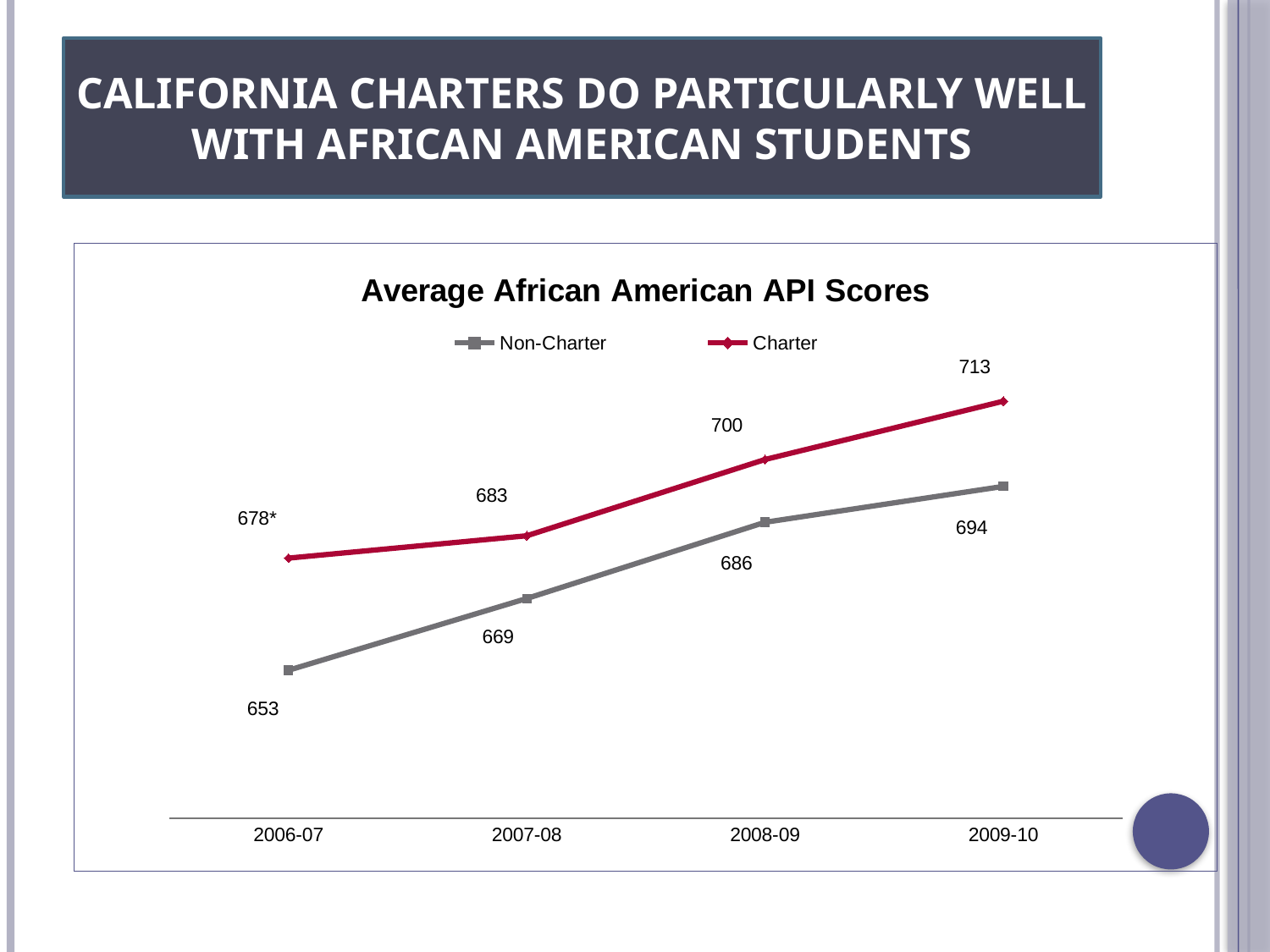
In which year is the Non-Charter score lowest? 2006-07 How many series does the legend list? 2 What kind of chart is shown? Line chart Do the Non-Charter scores rise or fall from 2006-07 to 2009-10? Rise How many years are shown on the x axis? 4 What is the difference between the Charter and Non-Charter scores in 2009-10? 19 Which is larger in 2007-08, the Charter score or the Non-Charter score? Charter In which year is the Charter score highest? 2009-10 What is the Non-Charter value for 2006-07? 653 What is the Non-Charter value for 2008-09? 686 What is the Charter value for 2009-10? 713 What is the Charter value for 2006-07 as labelled on the chart? 678*